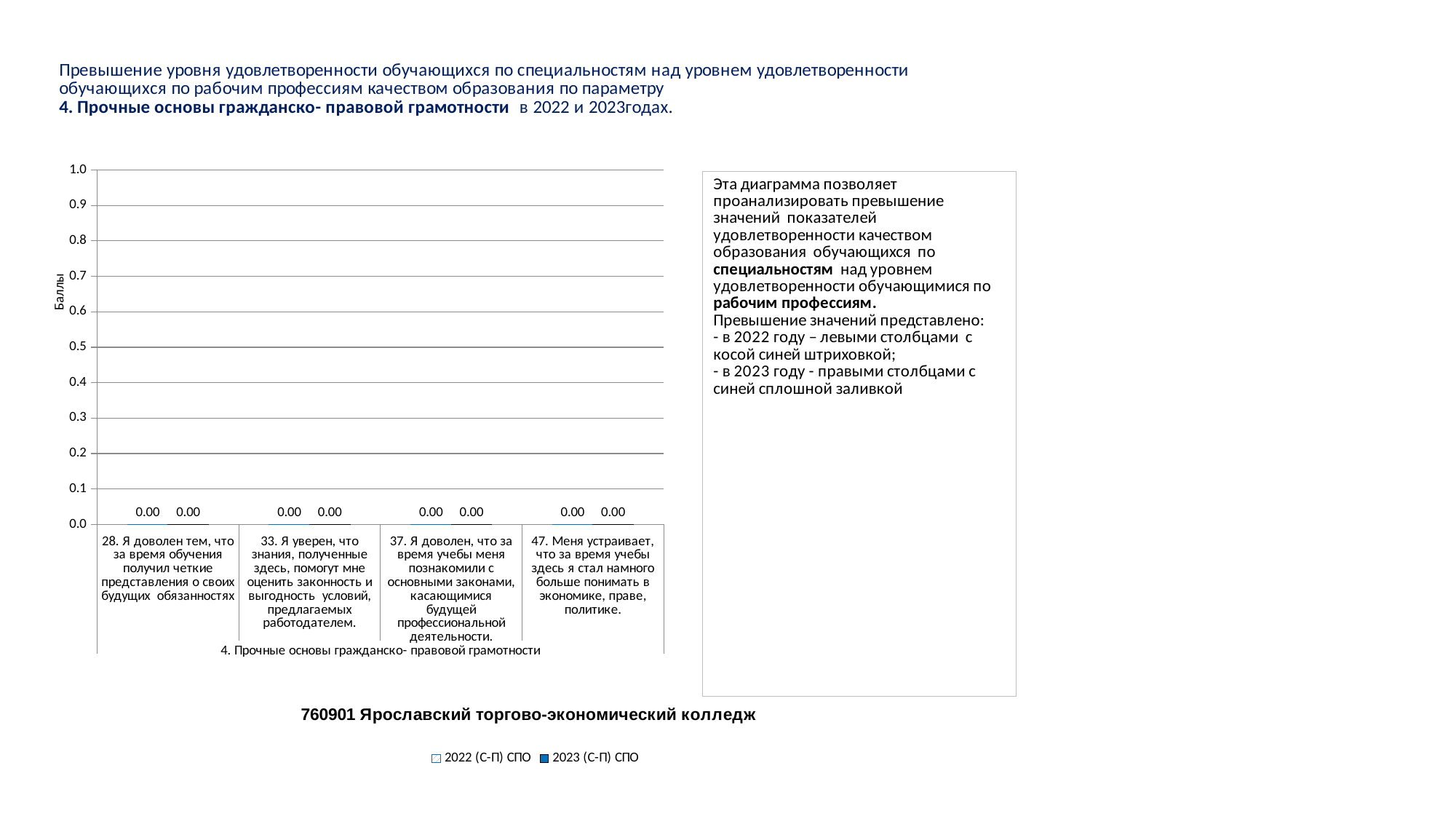
What kind of chart is shown on the slide? bar chart What is the label of the vertical axis of the chart? Баллы What is the difference between the 2022 (С-П) СПО and 2023 (С-П) СПО values for category 28? 0.00 What is the value for the 2022 (С-П) СПО series for category 37 ("Я доволен, что за время учебы меня познакомили с основными законами, касающимися будущей профессиональной деятельности")? 0.00 What is the value for the 2023 (С-П) СПО series for category 47 ("Меня устраивает, что за время учебы здесь я стал намного больше понимать в экономике, праве, политике")? 0.00 Do the values for the 2022 (С-П) СПО series rise, fall, or stay the same across the categories on the x axis? stay the same How many categories are shown on the x axis of the chart? 4 How many series does the chart legend list? 2 Is the value for the 2023 (С-П) СПО series for category 37 greater or less than 0.1? less What is the value for the 2022 (С-П) СПО series for category 28 ("Я доволен тем, что за время обучения получил четкие представления о своих будущих обязанностях")? 0.00 What is the value for the 2023 (С-П) СПО series for category 33 ("Я уверен, что знания, полученные здесь, помогут мне оценить законность и выгодность условий, предлагаемых работодателем")? 0.00 What is the title shown below the chart? 760901 Ярославский торгово-экономический колледж